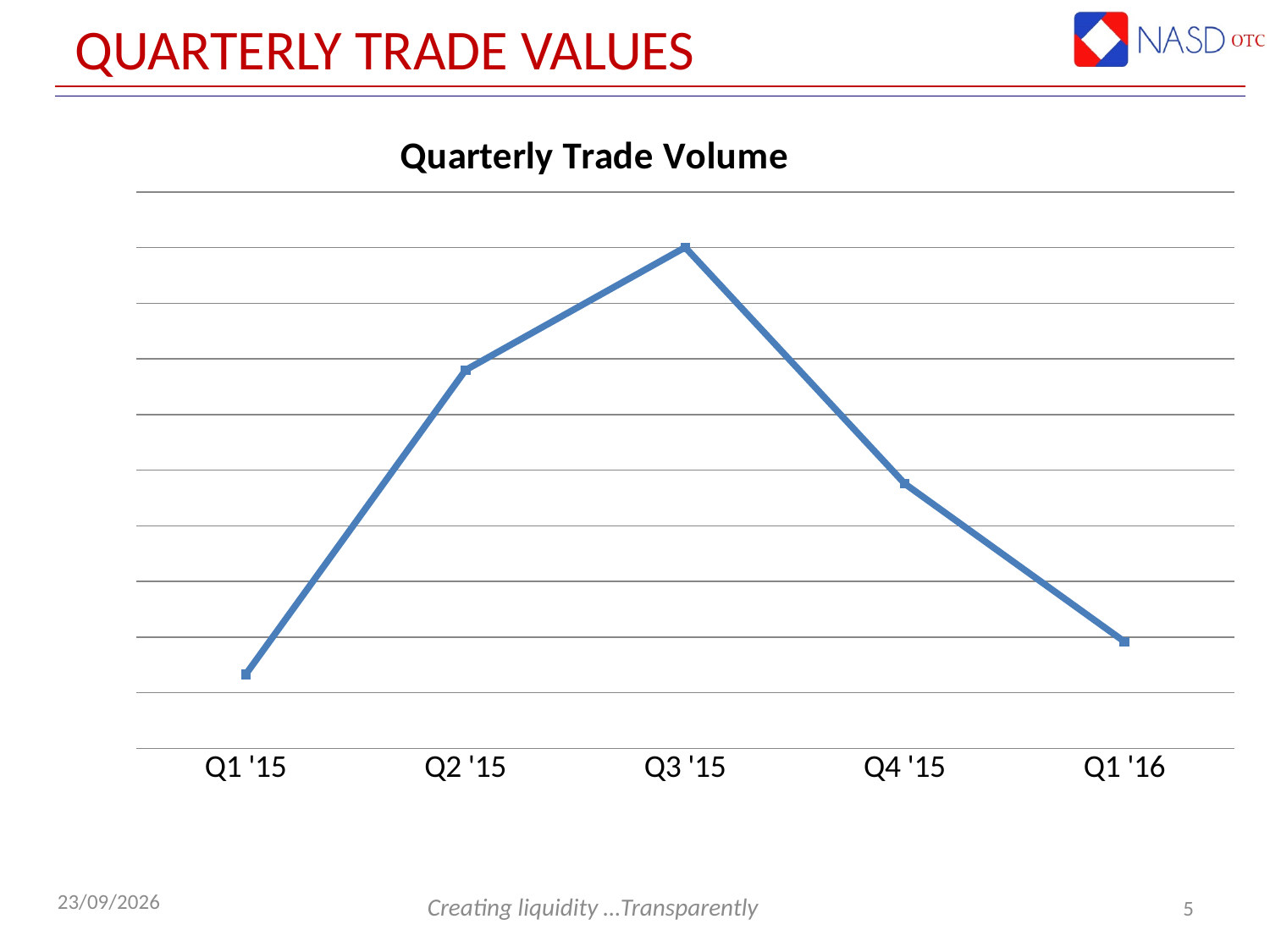
Which quarter has the higher trade volume, Q2 '15 or Q4 '15? Q2 '15 Which quarter has the second-highest trade volume in the chart? Q2 '15 Which quarter has the higher trade volume, Q4 '15 or Q1 '16? Q4 '15 Which quarter has the lowest trade volume in the chart? Q1 '15 How many quarters are plotted on the x axis of the chart? 5 Which quarter has the higher trade volume, Q1 '15 or Q1 '16? Q1 '16 Which quarter has the highest trade volume in the chart? Q3 '15 What type of chart is shown on the slide? Line chart What is the first quarter shown on the x axis of the chart? Q1 '15 Does the trade volume rise or fall from Q1 '15 to Q3 '15? Rise What is the title of the chart? Quarterly Trade Volume Does the trade volume rise or fall from Q3 '15 to Q1 '16? Fall